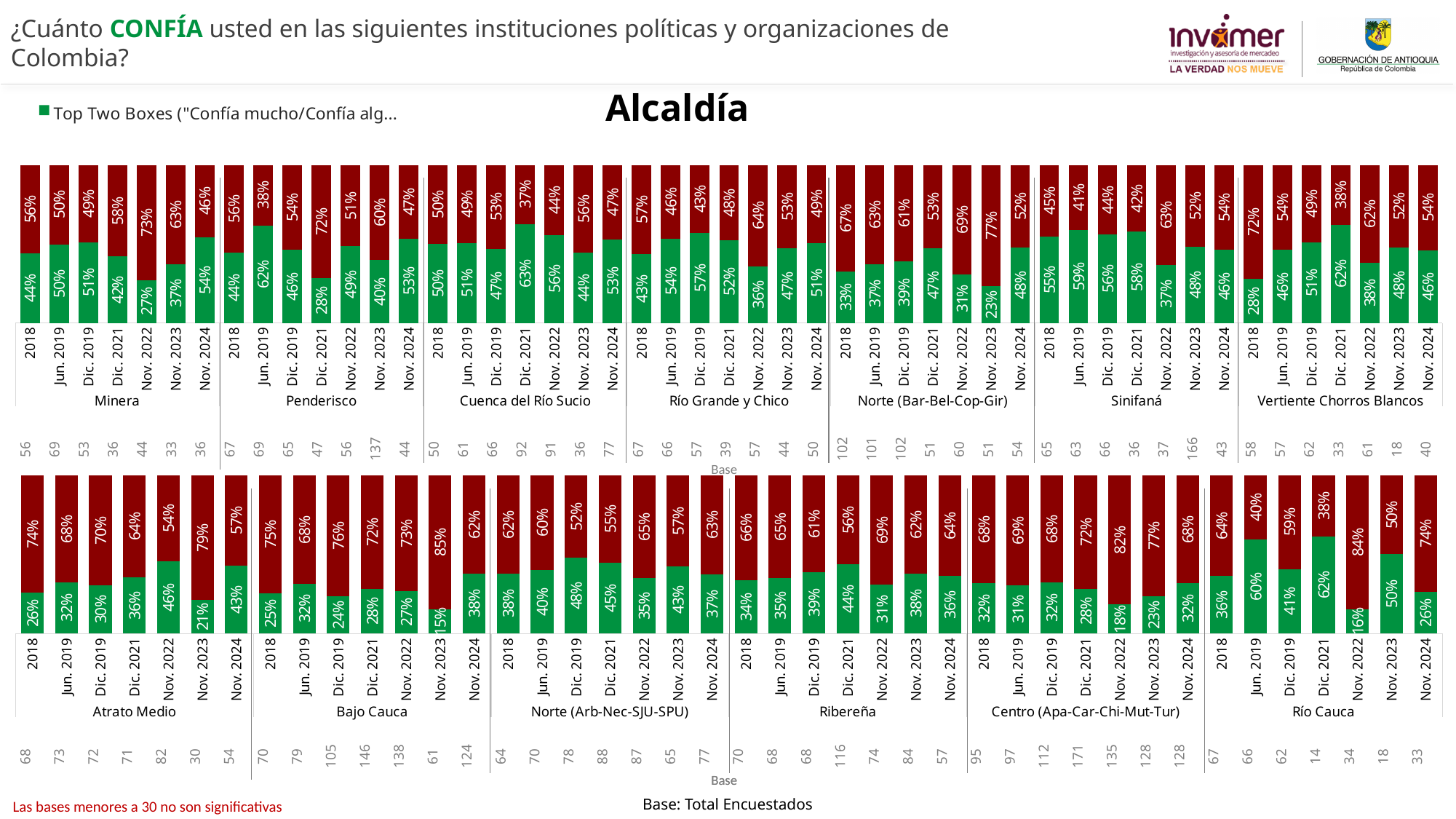
In the bottom chart, which period has the highest green (Top Two Boxes) value for Bajo Cauca? Nov. 2024 In the bottom chart, do the green values for Centro (Apa-Car-Chi-Mut-Tur) rise or fall from Nov. 2022 to Nov. 2024? Rise How many regions are shown in the top chart? 7 In the top chart, what is the difference between the green values for Penderisco in Jun. 2019 and Dic. 2021? 34 percentage points In the top chart, which period has the lowest green (Top Two Boxes) value for Norte (Bar-Bel-Cop-Gir)? Nov. 2023 In the top chart, what is the red segment value for Vertiente Chorros Blancos in Dic. 2021? 38% In the bottom chart, what is the green (Top Two Boxes) value for Río Cauca in Dic. 2021? 62% How many regions are shown in the bottom chart? 6 In the bottom chart, which is larger for Atrato Medio: the green value in Nov. 2022 or in Nov. 2024? Nov. 2022 In the top chart, what is the green (Top Two Boxes) value for Minera in Nov. 2022? 27% In the top chart, what is the total of the green and red segments for Sinifaná in 2018? 100% What type of chart is used on this slide? Stacked bar chart